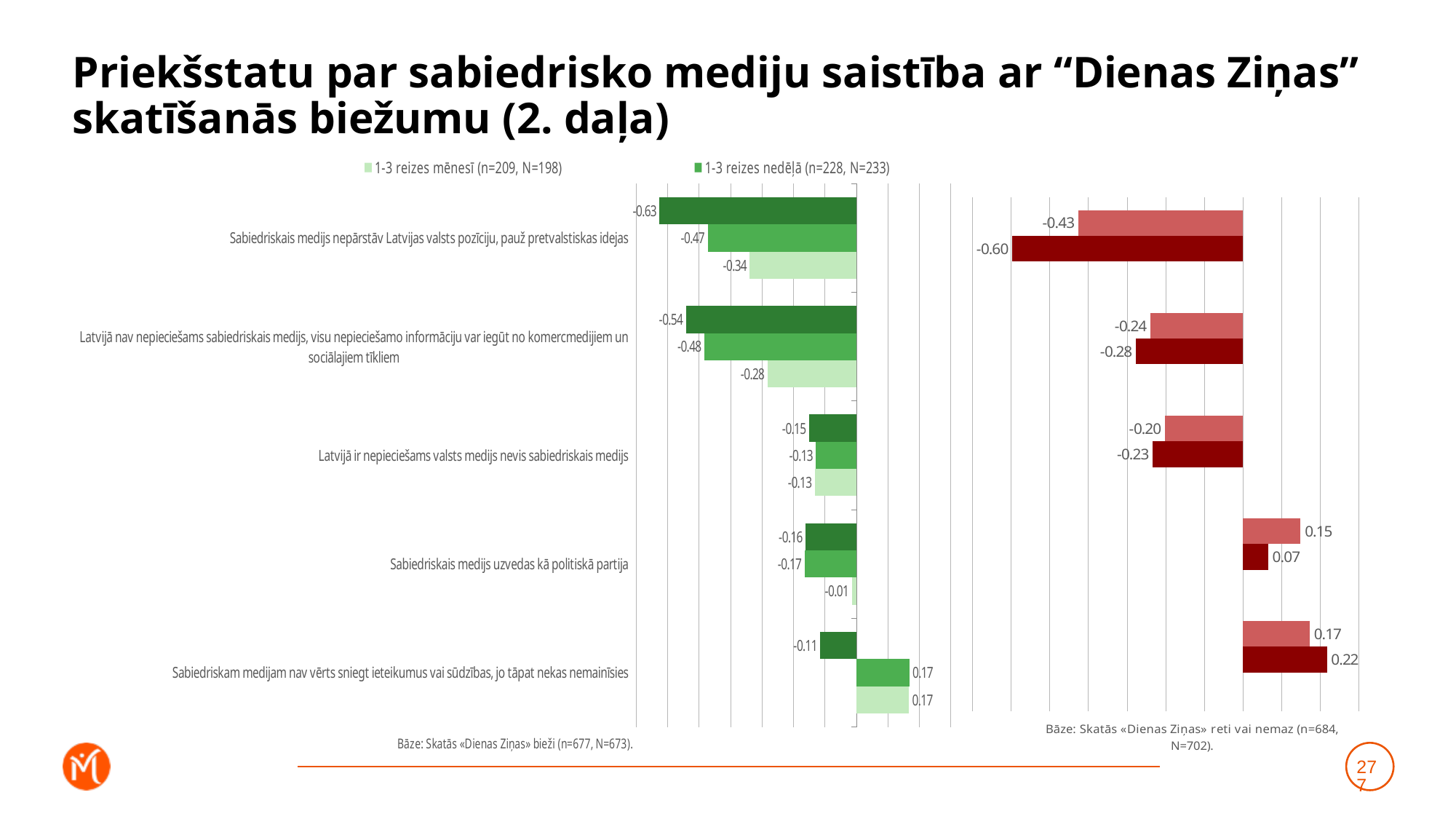
How many series does the legend list? 2 What kind of chart is shown on the left side of the slide? bar chart What is the lowest value labelled in the right chart? -0.60 In the left chart, what is the value for '1-3 reizes nedēļā' for 'Latvijā nav nepieciešams sabiedriskais medijs, visu nepieciešamo informāciju var iegūt no komercmedijiem un sociālajiem tīkliem'? -0.48 In the left chart, which category has the highest value for '1-3 reizes mēnesī'? Sabiedriskam medijam nav vērts sniegt ieteikumus vai sūdzības, jo tāpat nekas nemainīsies In the left chart, what is the value for '1-3 reizes nedēļā' for 'Sabiedriskam medijam nav vērts sniegt ieteikumus vai sūdzības, jo tāpat nekas nemainīsies'? 0.17 In the left chart, for 'Latvijā nav nepieciešams sabiedriskais medijs...', which series has the larger value: '1-3 reizes mēnesī' or '1-3 reizes nedēļā'? 1-3 reizes mēnesī In the left chart, what is the value for '1-3 reizes mēnesī' for 'Sabiedriskais medijs nepārstāv Latvijas valsts pozīciju, pauž pretvalstiskas idejas'? -0.34 In the left chart, which category has the lowest value for '1-3 reizes nedēļā'? Latvijā nav nepieciešams sabiedriskais medijs, visu nepieciešamo informāciju var iegūt no komercmedijiem un sociālajiem tīkliem How many statement categories are plotted in the left chart? 5 In the left chart, what is the value for '1-3 reizes mēnesī' for 'Sabiedriskais medijs uzvedas kā politiskā partija'? -0.01 In the left chart, what is the difference between the '1-3 reizes nedēļā' value (-0.47) and the '1-3 reizes mēnesī' value (-0.34) for 'Sabiedriskais medijs nepārstāv Latvijas valsts pozīciju, pauž pretvalstiskas idejas'? 0.13